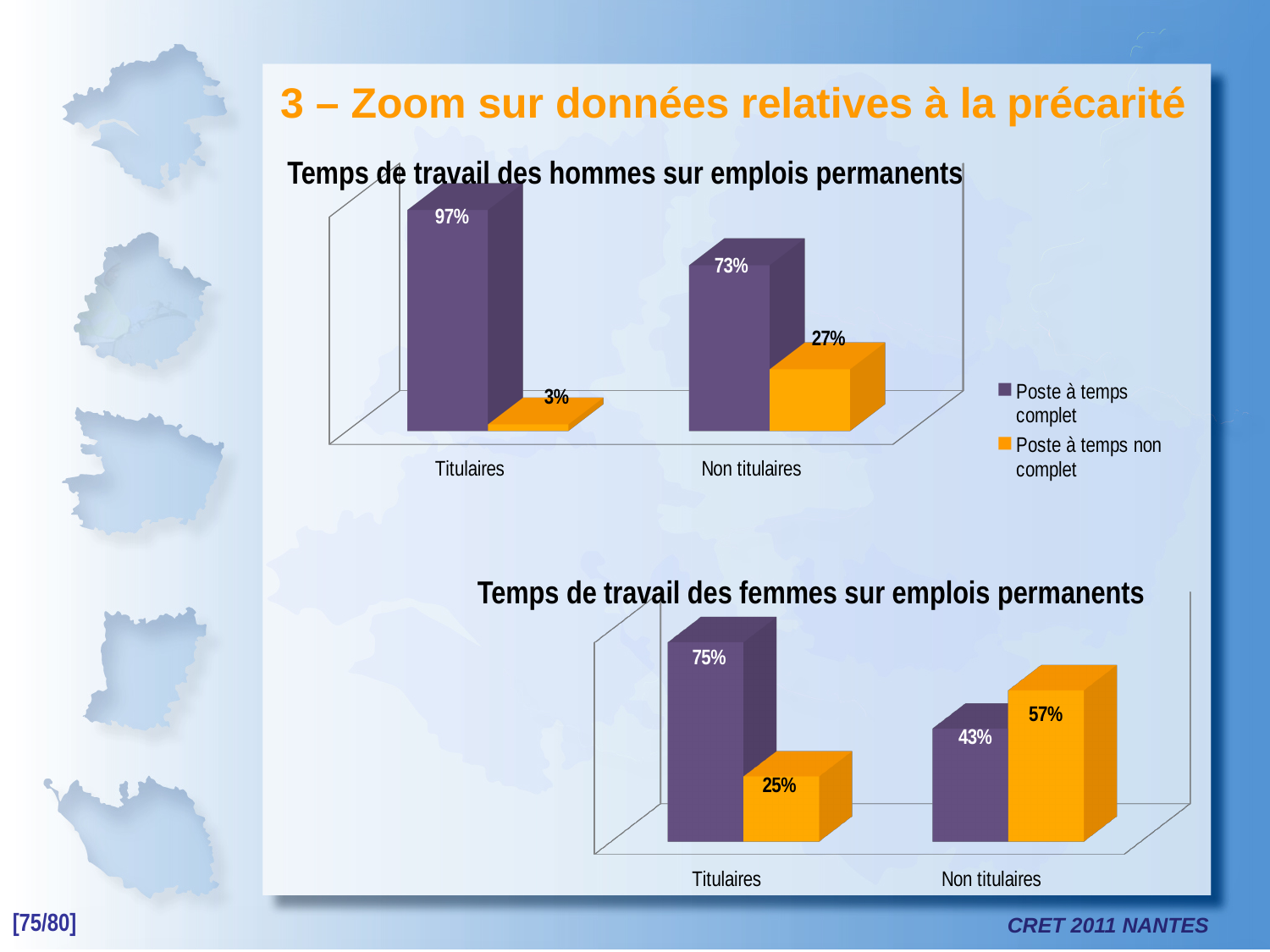
In the chart 'Temps de travail des hommes sur emplois permanents', what is the difference between the Poste à temps complet values for Titulaires and Non titulaires? 24% In the chart 'Temps de travail des femmes sur emplois permanents', what is the value for Poste à temps complet for Non titulaires? 43% What kind of chart is 'Temps de travail des femmes sur emplois permanents'? Bar chart In the chart 'Temps de travail des hommes sur emplois permanents', what is the value for Poste à temps non complet for Non titulaires? 27% How many series does the legend of the chart 'Temps de travail des hommes sur emplois permanents' list? 2 In the chart 'Temps de travail des hommes sur emplois permanents', which category has the lowest Poste à temps non complet value? Titulaires In the chart 'Temps de travail des femmes sur emplois permanents', which category has the highest Poste à temps complet value? Titulaires How many categories are shown on the x axis of the chart 'Temps de travail des hommes sur emplois permanents'? 2 In the chart 'Temps de travail des femmes sur emplois permanents', what is the difference between Poste à temps non complet and Poste à temps complet for Non titulaires? 14% In the chart 'Temps de travail des femmes sur emplois permanents', what is the value for Poste à temps non complet for Titulaires? 25% In the chart 'Temps de travail des hommes sur emplois permanents', what is the value for Poste à temps complet for Titulaires? 97% In the chart 'Temps de travail des femmes sur emplois permanents', which is larger for Non titulaires: Poste à temps complet or Poste à temps non complet? Poste à temps non complet